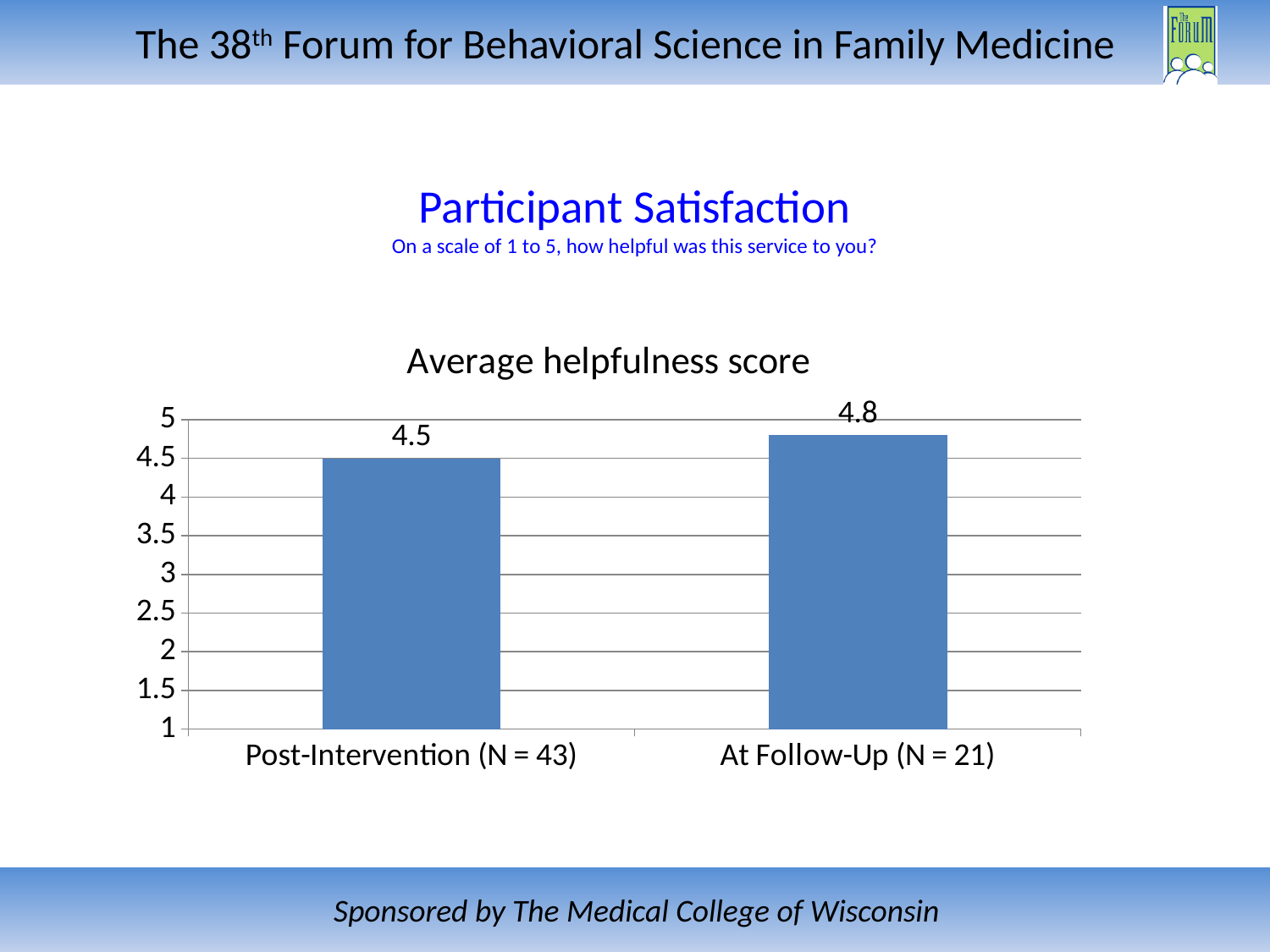
What is the difference between the At Follow-Up score and the Post-Intervention score? 0.3 Which category has the lowest average helpfulness score? Post-Intervention (N = 43) What kind of chart is shown on the slide? Bar chart How many categories are shown on the x axis of the chart? 2 What is the title of the chart? Average helpfulness score What is the lowest value shown on the y axis of the chart? 1 Do the values rise or fall from Post-Intervention to At Follow-Up? Rise Which is larger, the Post-Intervention score or the At Follow-Up score? At Follow-Up What is the average helpfulness score At Follow-Up (N = 21)? 4.8 Which category has the highest average helpfulness score? At Follow-Up (N = 21) Is the value for Post-Intervention (N = 43) greater or less than 4? greater What is the average helpfulness score for Post-Intervention (N = 43)? 4.5